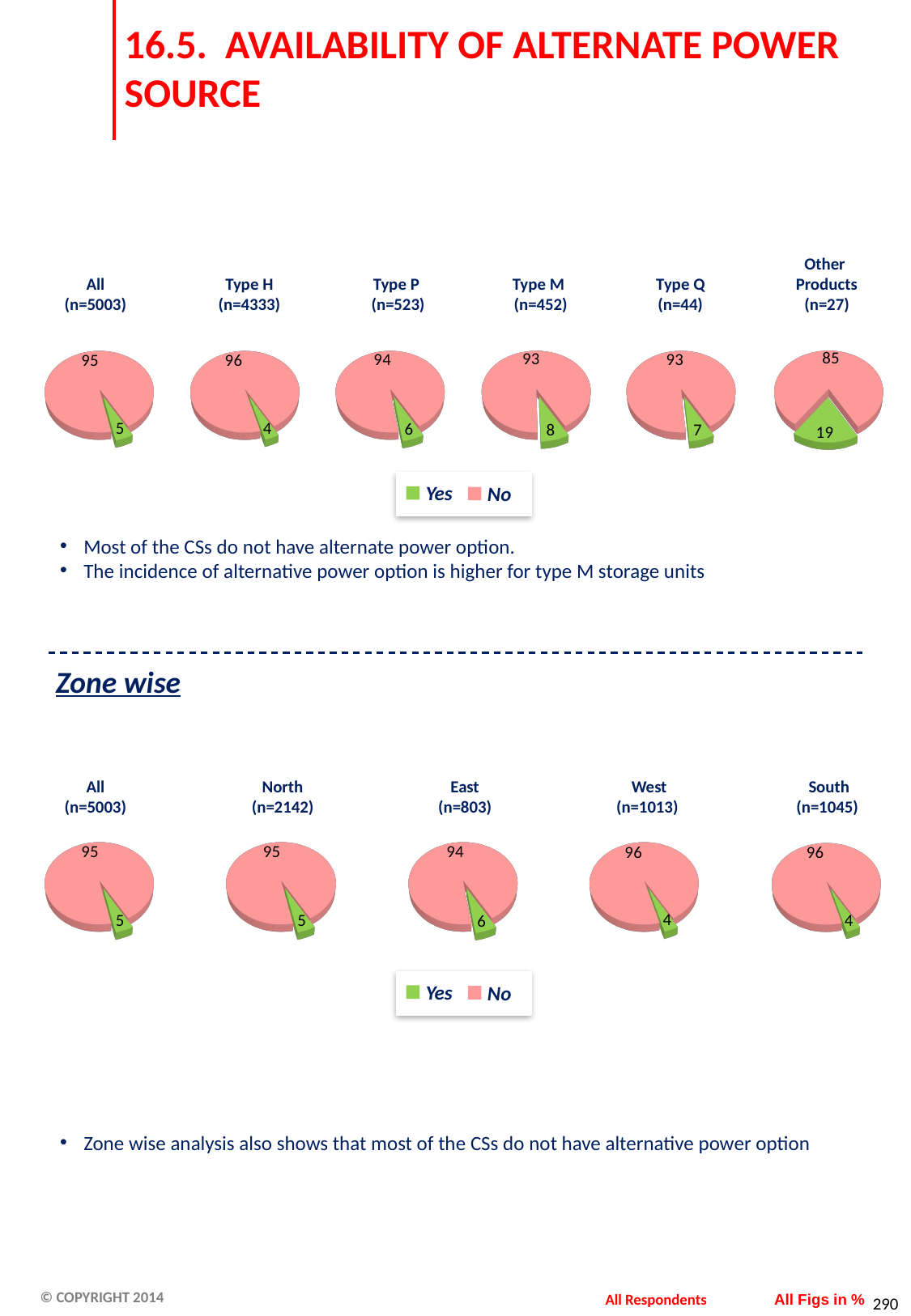
What type of chart is used for the Type Q (n=44) data? Pie chart In the Zone wise pie charts, which has the larger 'Yes' value, North or South? North Among the top row of pie charts, which category has the lowest 'Yes' value? Type H (n=4333) In the top row of pie charts, what is the difference between the 'Yes' value for Other Products and the 'Yes' value for Type P? 13 Among the top row of pie charts, which category has the highest 'Yes' value? Other Products (n=27) In the top row of pie charts, what is the 'Yes' value for Type H (n=4333)? 4 How many entries does the legend below the top row of pie charts list? 2 In the Zone wise pie charts, what is the 'Yes' value for East (n=803)? 6 In the top row of pie charts, what is the 'No' value for Other Products (n=27)? 85 In the Zone wise pie charts, what is the 'No' value for West (n=1013)? 96 In the top row of pie charts, what is the 'Yes' value for Type M (n=452)? 8 How many pie charts are in the Zone wise section? 5